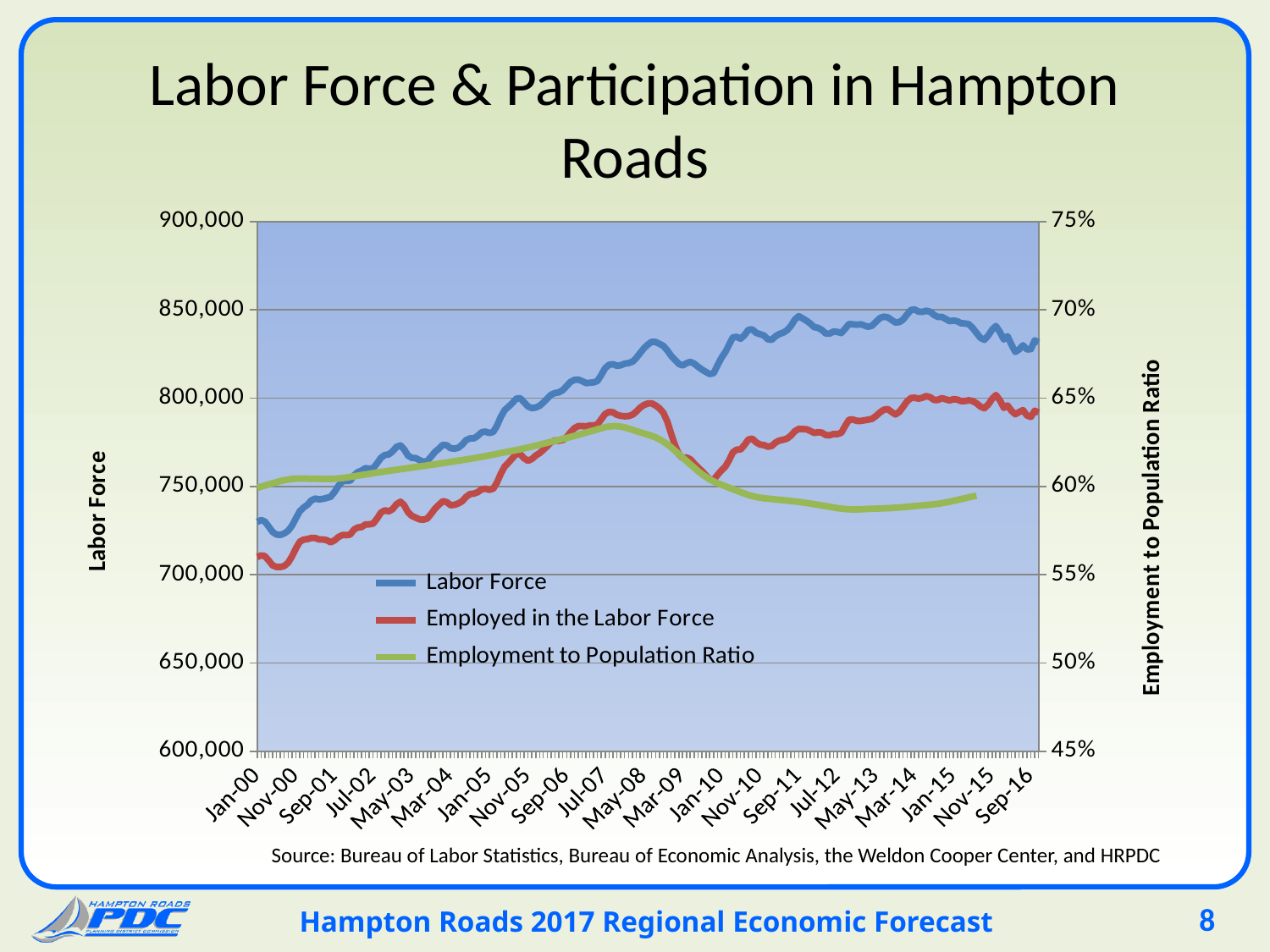
Is the Labor Force value at Sep-16 greater or less than 800,000? greater Is the Employment to Population Ratio at Jul-07 greater or less than 60%? greater Does the Labor Force series generally rise or fall from Jan-00 to Mar-14? rise Which series is plotted against the right-hand axis labelled Employment to Population Ratio? Employment to Population Ratio Does the Employment to Population Ratio rise or fall from Jul-07 to May-13? fall What kind of chart is shown on the slide? line chart Is the Employment to Population Ratio at May-13 greater or less than 60%? less How many series does the legend list? 3 What is the title of the chart? Labor Force & Participation in Hampton Roads At Sep-16, which is larger: Labor Force or Employed in the Labor Force? Labor Force